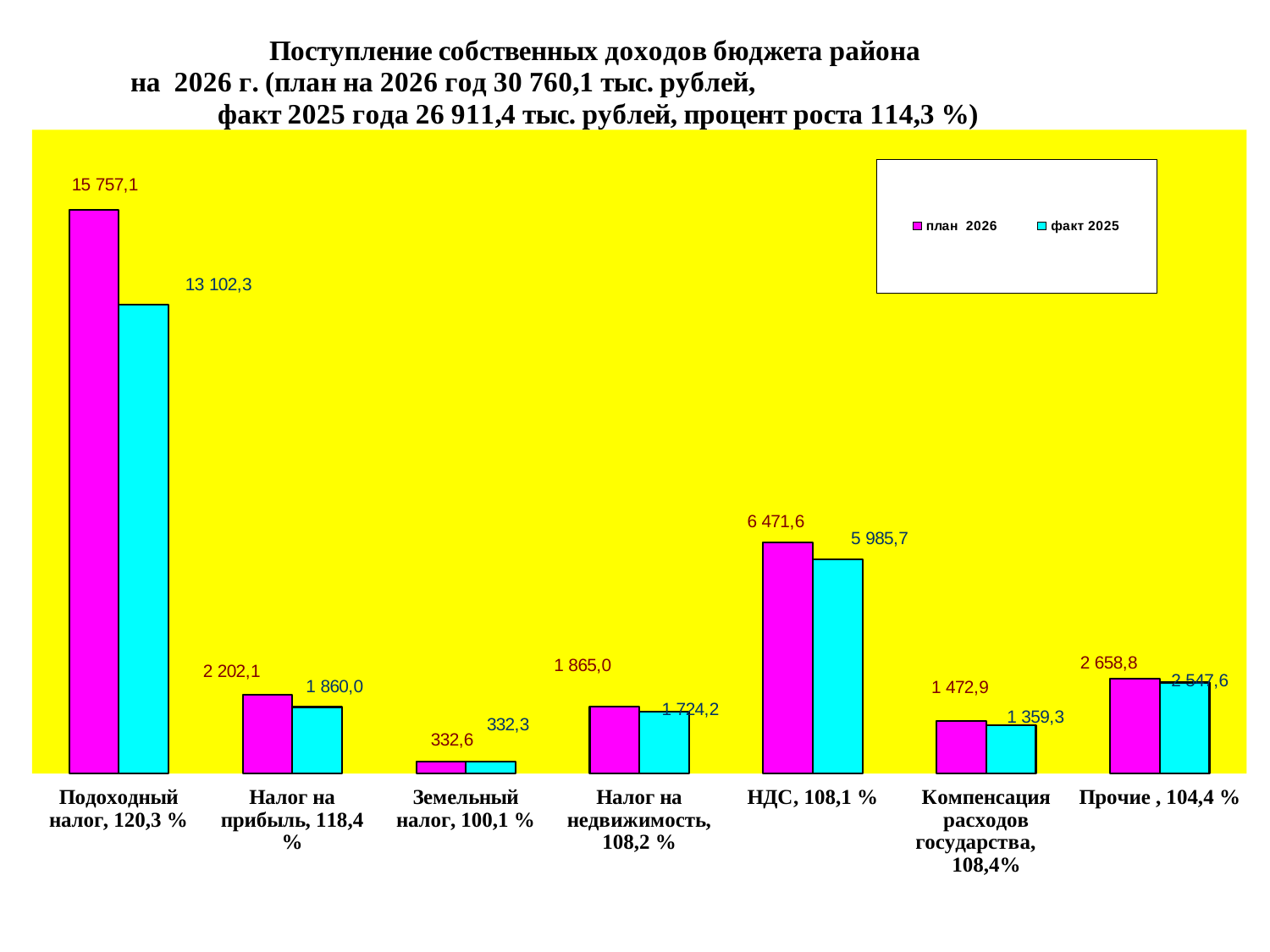
What is the план 2026 value for Подоходный налог? 15 757,1 What is the факт 2025 value for Прочие? 2 547,6 What is the difference between the план 2026 and факт 2025 values for Подоходный налог? 2 654,8 Which category has the lowest факт 2025 value? Земельный налог Which is larger for Налог на прибыль: the план 2026 value or the факт 2025 value? план 2026 What kind of chart is shown on the slide? Bar chart How many series does the legend list? 2 What is the difference between the план 2026 and факт 2025 values for НДС? 485,9 Which category has the highest план 2026 value? Подоходный налог What is the факт 2025 value for НДС? 5 985,7 How many categories are shown on the x axis? 7 What is the план 2026 value for Компенсация расходов государства? 1 472,9